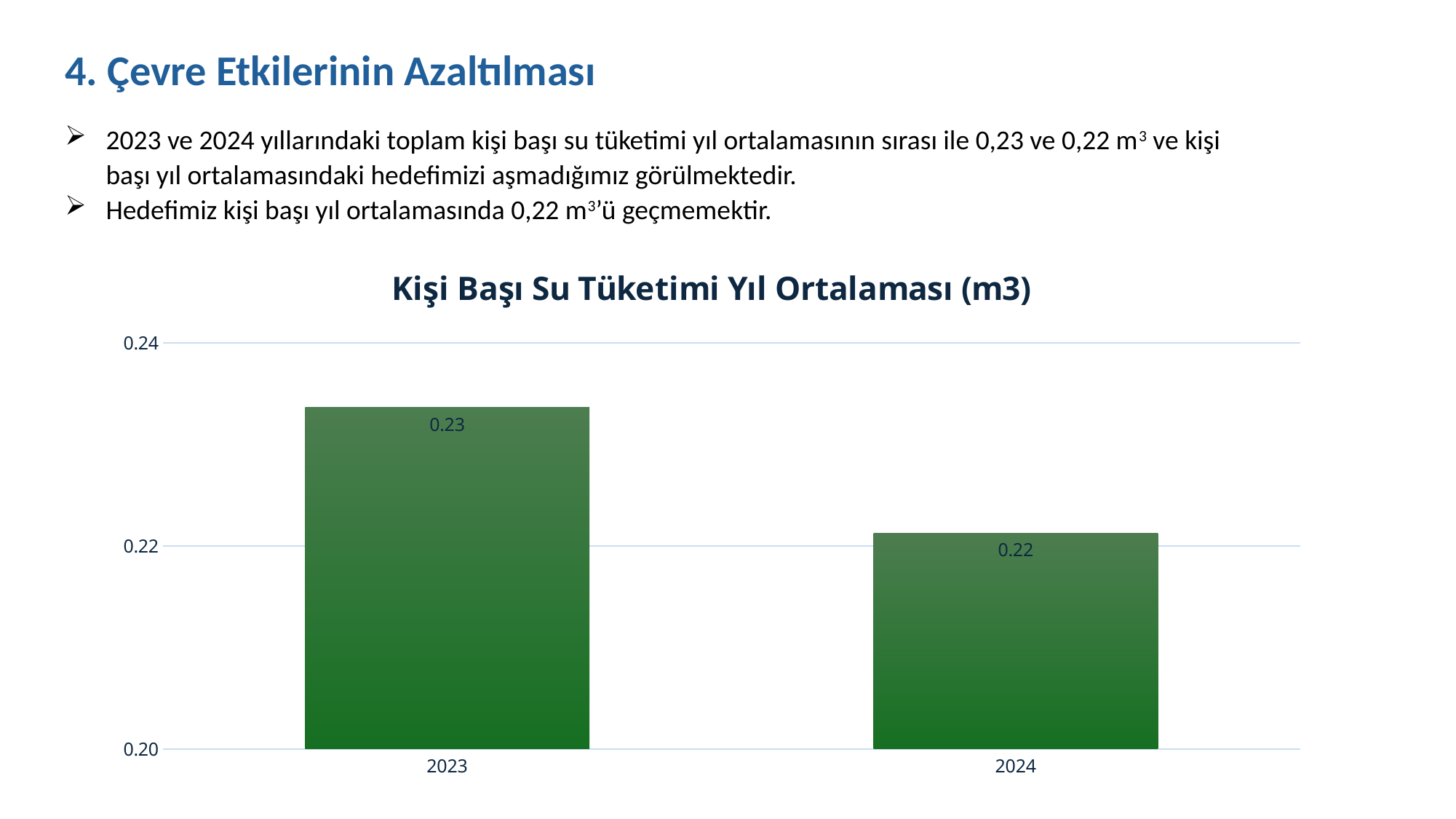
What kind of chart is shown on the slide? bar chart Is the value for 2023 greater or less than 0.22? greater Do the values rise or fall from 2023 to 2024? fall How many years are shown in the chart? 2 What is the difference between the 2023 and 2024 values? 0.01 Which year has the highest per-capita water consumption in the chart? 2023 What is the value for 2023 in the chart? 0.23 Is the value for 2024 greater or less than 0.24? less Which year has the lowest value in the chart? 2024 What is the title of the chart? Kişi Başı Su Tüketimi Yıl Ortalaması (m3) What is the value for 2024 in the chart? 0.22 Which is larger, the value for 2023 or the value for 2024? 2023